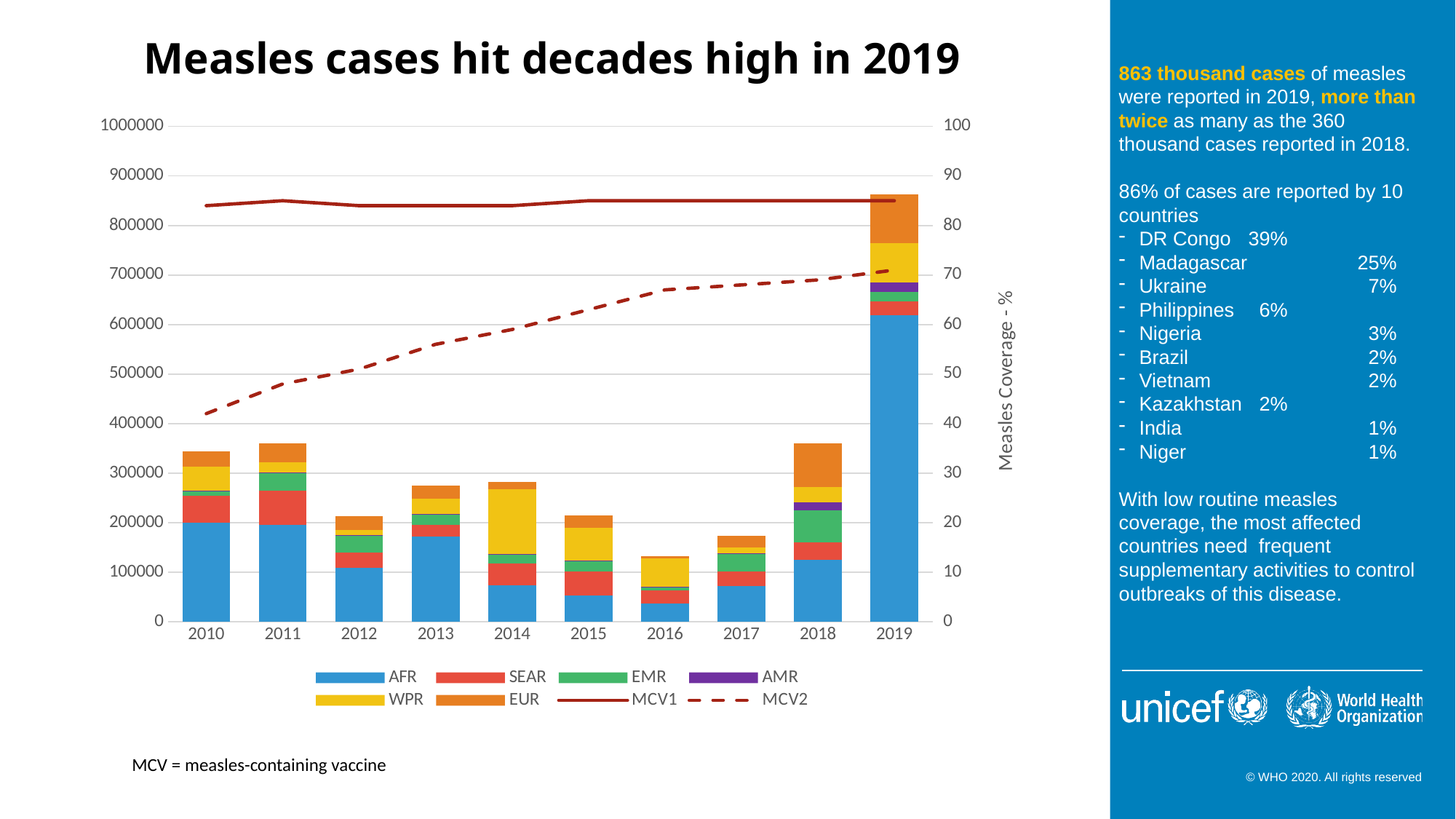
Is the total stacked bar for 2016 greater or less than 200000? less Is the MCV1 coverage value for 2019 greater or less than 80? greater Is the total stacked bar for 2019 greater or less than 800000? greater Does the MCV2 coverage line rise or fall from 2010 to 2019? rise Which year has the highest total stacked bar of measles cases? 2019 Which year has the lowest total stacked bar of measles cases? 2016 What is the title of the chart? Measles cases hit decades high in 2019 How many series does the legend list? 8 How many years are shown on the x axis? 10 Which year has the larger total stacked bar, 2017 or 2018? 2018 What kind of chart is shown on the slide? A stacked bar chart combined with line series